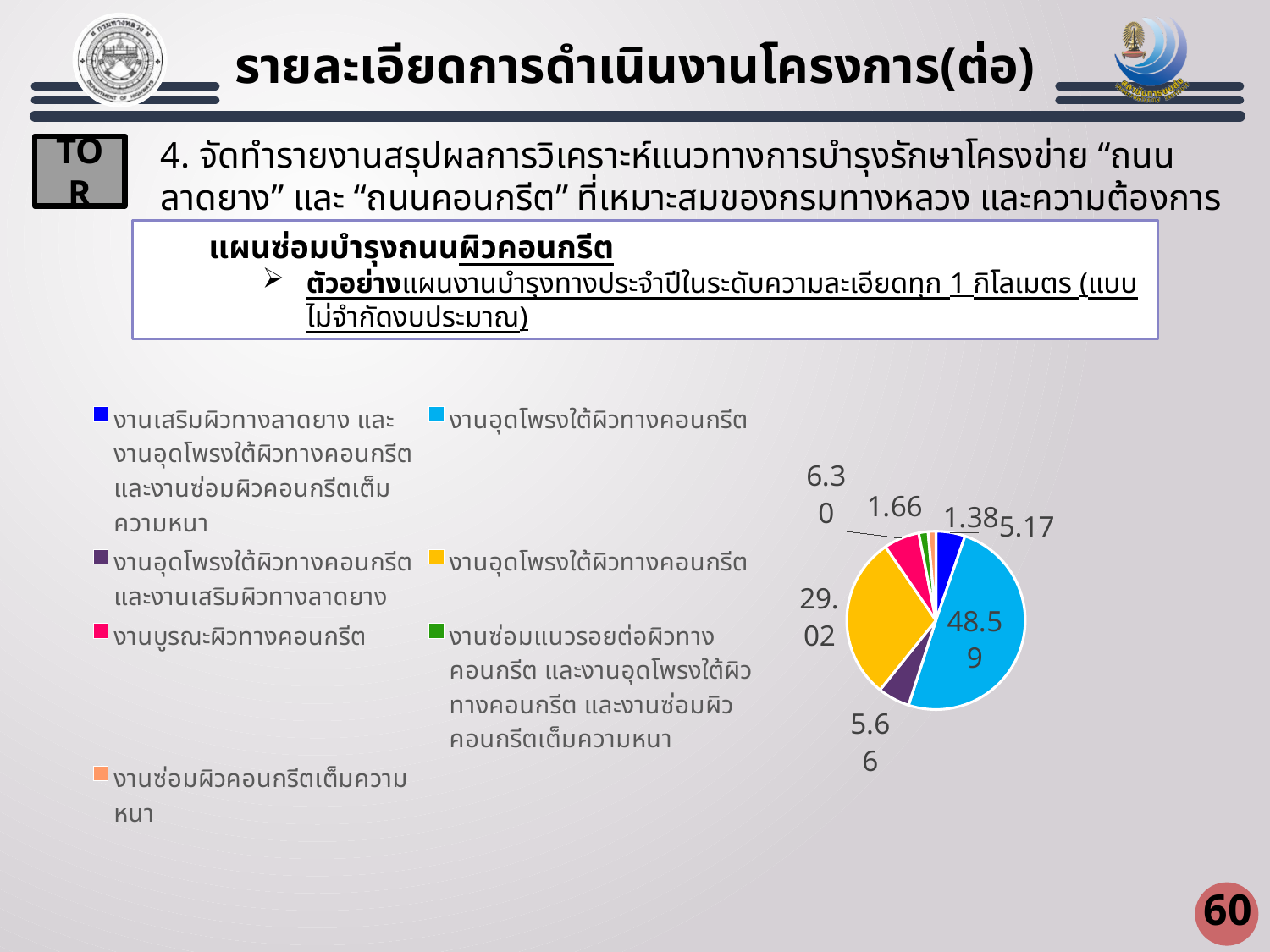
What value is labelled on the yellow slice of the pie chart? 29.02 What kind of chart is shown on the slide? pie chart Which legend entry corresponds to the light blue slice of the pie chart? งานอุดโพรงใต้ผิวทางคอนกรีต What is the largest value labelled on the pie chart? 48.59 What value is labelled on the purple slice of the pie chart? 5.66 How many entries does the legend of the pie chart list? 7 How many slices are labelled with values on the pie chart? 7 What is the difference between the light blue slice (48.59) and the yellow slice (29.02) on the pie chart? 19.57 What value is labelled on the pink slice of the pie chart? 6.30 What value is labelled on the light blue slice of the pie chart? 48.59 Which slice is larger on the pie chart, the light blue one or the yellow one? the light blue one What is the smallest value labelled on the pie chart? 1.38